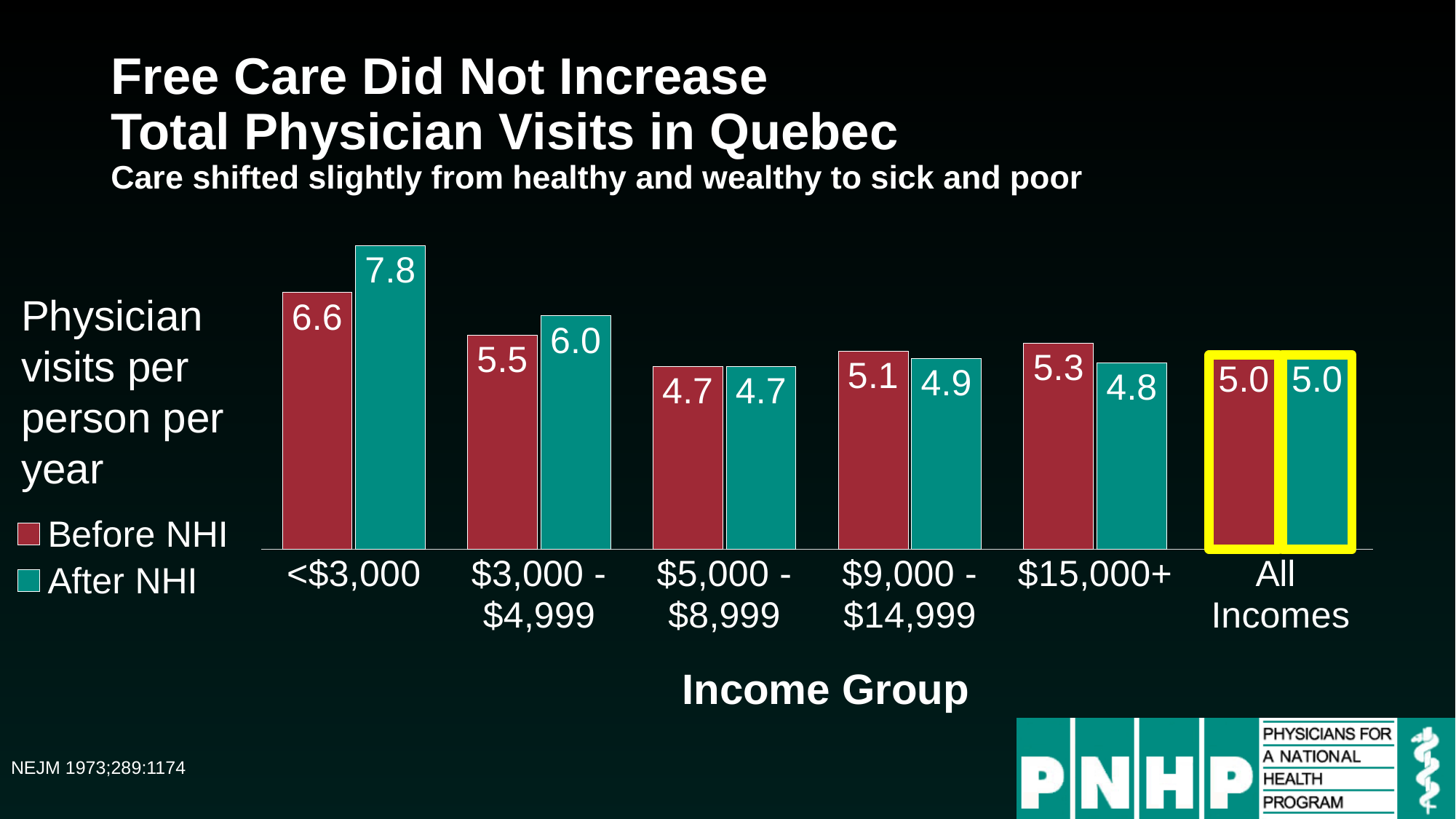
What was the number of physician visits per person per year for the $15,000+ income group before NHI? 5.3 What is the value for All Incomes before NHI? 5.0 Which income group had the lowest number of physician visits before NHI? $5,000 - $8,999 What is the difference between the after NHI and before NHI values for the <$3,000 income group? 1.2 How many income groups are shown on the x axis? 6 What was the value for the $9,000 - $14,999 income group after NHI? 4.9 Which income group had the highest number of physician visits after NHI? <$3,000 For the $15,000+ income group, which is larger: the before NHI value or the after NHI value? Before NHI What was the number of physician visits per person per year for the <$3,000 income group after NHI? 7.8 What kind of chart is shown on the slide? Bar chart What is the x axis title of the chart? Income Group How many series does the legend list? 2